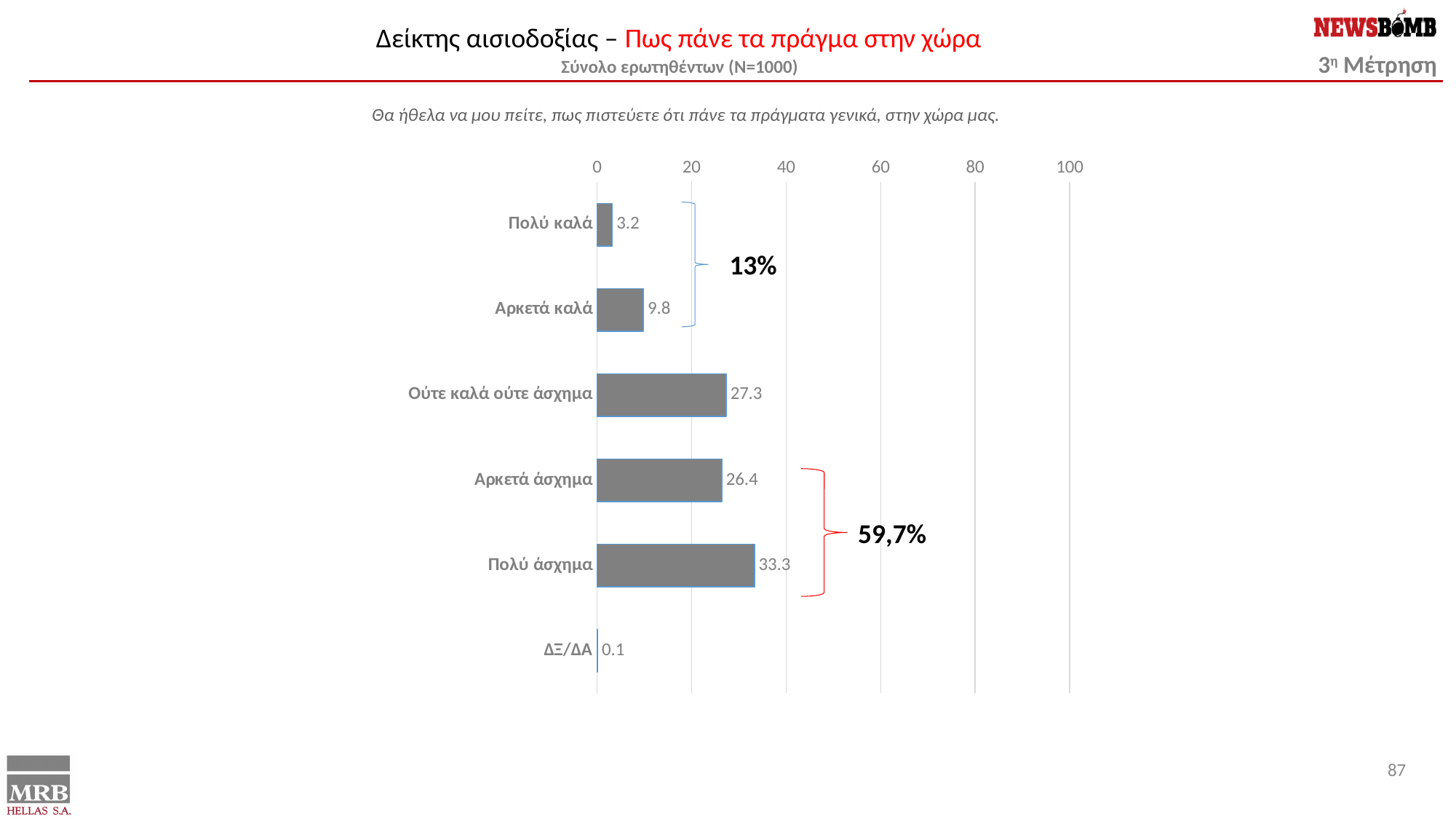
Which is larger, the value for Αρκετά καλά or the value for Αρκετά άσχημα? Αρκετά άσχημα What kind of chart is shown on the slide? Bar chart What is the value for ΔΞ/ΔΑ? 0.1 Which category has the lowest value? ΔΞ/ΔΑ What is the value for Πολύ καλά? 3.2 Which category has the highest value? Πολύ άσχημα What combined percentage is shown by the red bracket for Αρκετά άσχημα and Πολύ άσχημα? 59,7% What is the difference between the values for Πολύ άσχημα and Αρκετά άσχημα? 6.9 How many categories are shown in the chart? 6 What is the value for Πολύ άσχημα? 33.3 What is the value for Αρκετά καλά? 9.8 What is the value for Ούτε καλά ούτε άσχημα? 27.3